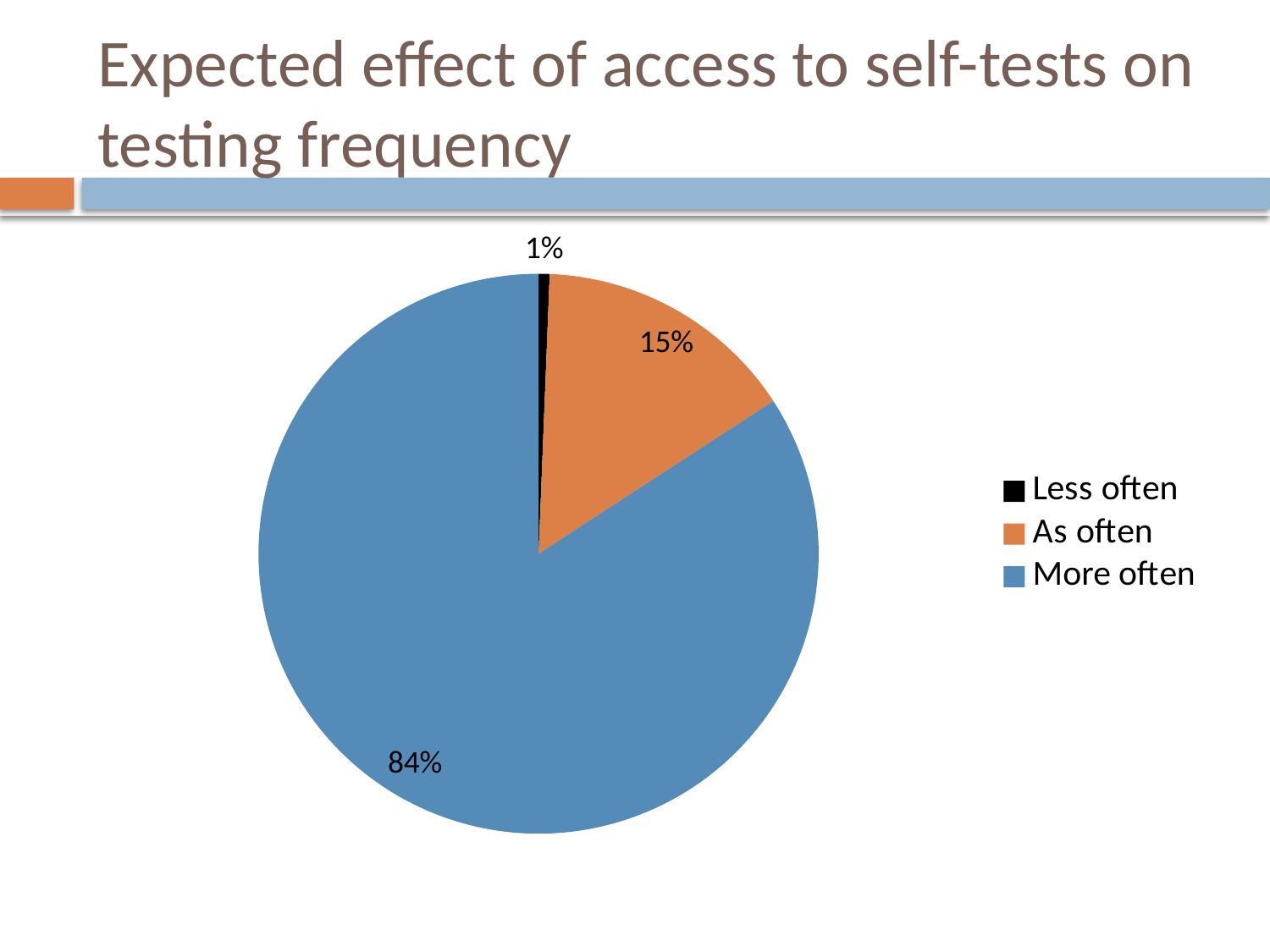
What colour is the "As often" slice? orange What kind of chart is shown on the slide? pie chart What share of the pie is labelled "As often"? 15% What is the title of the slide containing the pie chart? Expected effect of access to self-tests on testing frequency What is the difference in percentage points between the "As often" and "Less often" slices? 14 What share of the pie is labelled "More often"? 84% Which slice is larger, "As often" or "Less often"? As often What share of the pie is labelled "Less often"? 1% How many categories does the pie chart show? 3 Which category has the smallest slice of the pie? Less often What is the difference in percentage points between the "More often" and "As often" slices? 69 Which category has the largest slice of the pie? More often